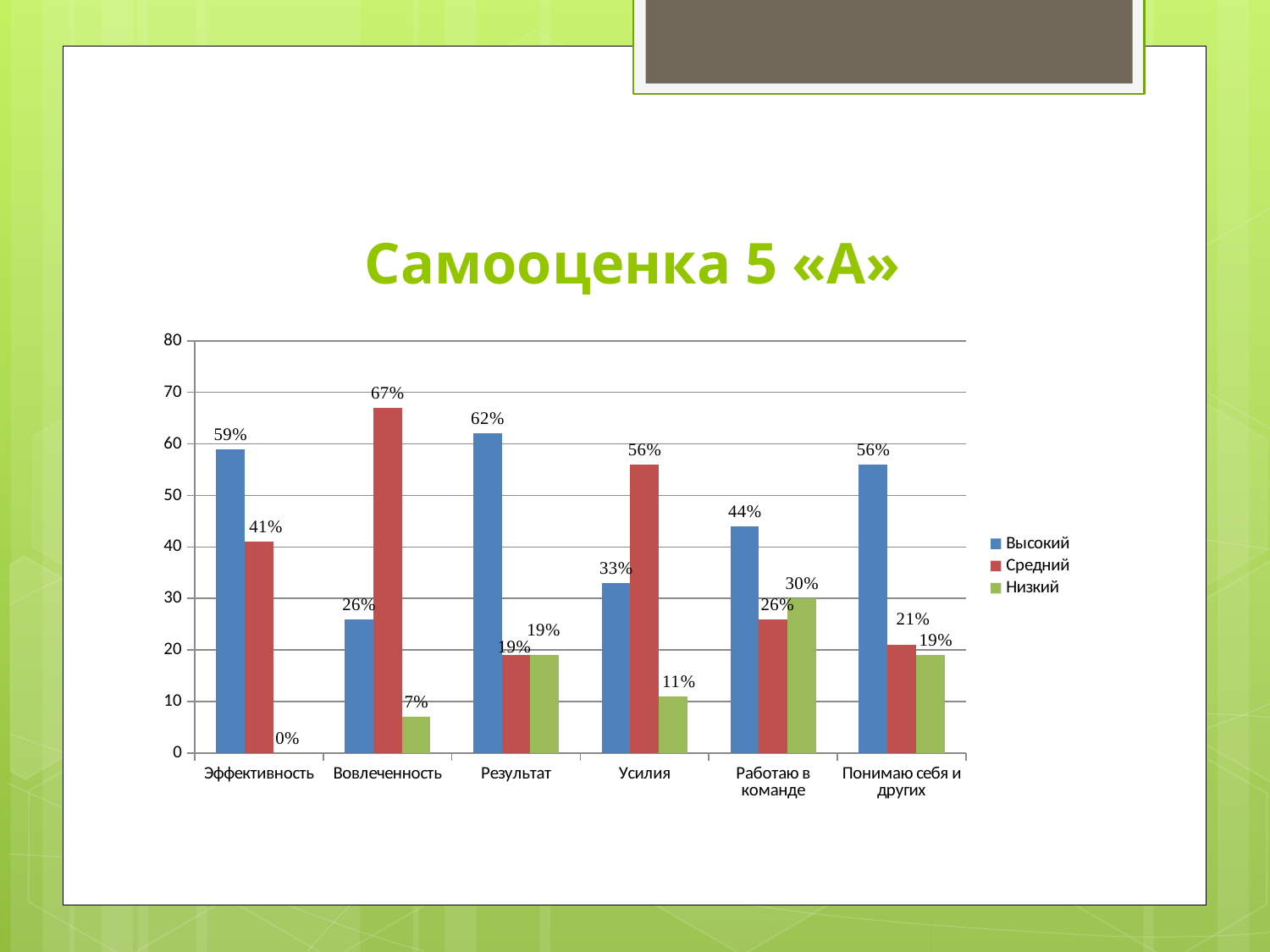
What is the difference between the Средний and Высокий values for Вовлеченность? 41% What is the title of the chart? Самооценка 5 «А» What is the value of Низкий for Эффективность? 0% Which is larger for Усилия: Высокий or Средний? Средний What kind of chart is shown on the slide? Bar chart What is the value of Высокий for Эффективность? 59% Which category has the lowest Средний value? Результат What is the value of Средний for Вовлеченность? 67% How many series does the legend list? 3 Which category has the highest Высокий value? Результат What is the value of Низкий for Работаю в команде? 30% How many categories are shown on the x axis? 6